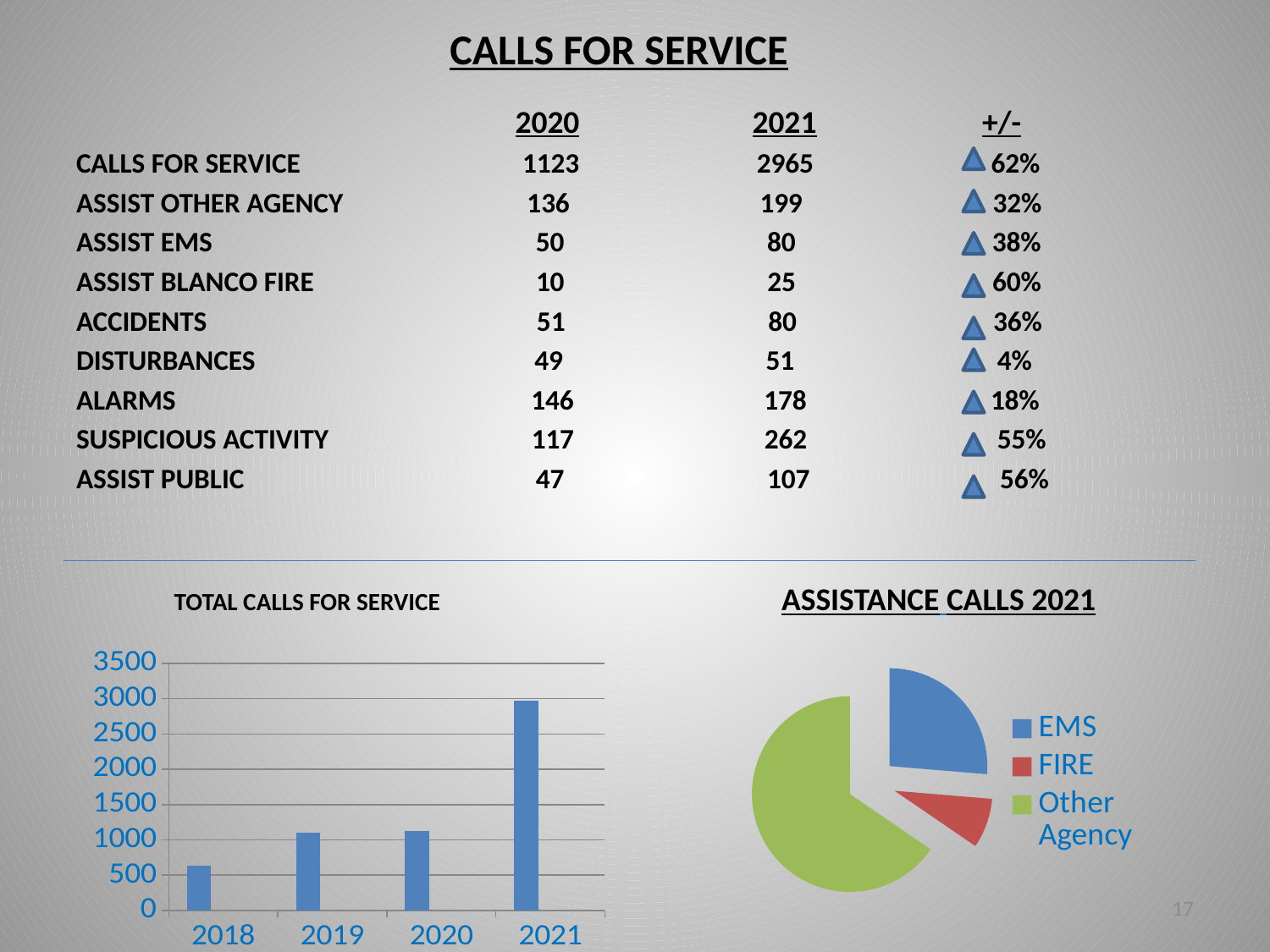
On the TOTAL CALLS FOR SERVICE chart, do the values generally rise or fall from 2018 to 2021? rise On the ASSISTANCE CALLS 2021 pie chart, which category has the largest slice? Other Agency What kind of chart is the ASSISTANCE CALLS 2021 chart? pie chart What kind of chart is the TOTAL CALLS FOR SERVICE chart? bar chart On the TOTAL CALLS FOR SERVICE chart, is the value for 2018 greater or less than 1000? less How many years are shown on the x axis of the TOTAL CALLS FOR SERVICE chart? 4 On the TOTAL CALLS FOR SERVICE chart, which year has the lowest bar? 2018 On the TOTAL CALLS FOR SERVICE chart, which year has the highest bar? 2021 On the TOTAL CALLS FOR SERVICE chart, is the value for 2020 greater or less than 1000? greater On the TOTAL CALLS FOR SERVICE chart, is the value for 2021 greater or less than 2500? greater On the ASSISTANCE CALLS 2021 pie chart, which category has the smallest slice? FIRE On the TOTAL CALLS FOR SERVICE chart, which is larger, the bar for 2021 or the bar for 2019? 2021